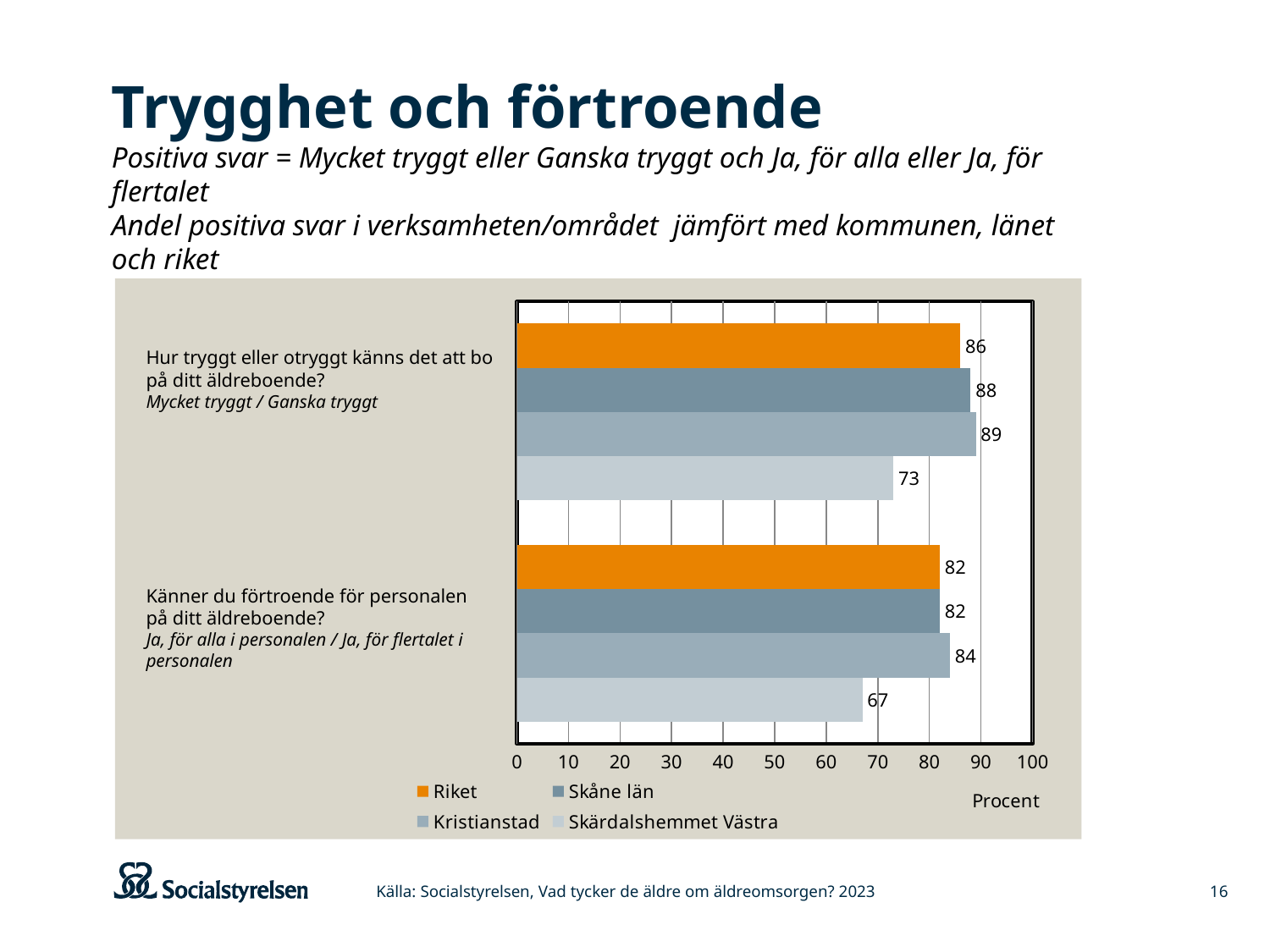
What is the value for Kristianstad on the question 'Känner du förtroende för personalen på ditt äldreboende?'? 84 What is the value for Skärdalshemmet Västra on the question 'Känner du förtroende för personalen på ditt äldreboende?'? 67 Which series has the lowest value on the question 'Känner du förtroende för personalen på ditt äldreboende?'? Skärdalshemmet Västra What unit label is shown under the x axis of the chart? Procent How many series does the legend list? 4 Which series has the highest value on the question 'Hur tryggt eller otryggt känns det att bo på ditt äldreboende?'? Kristianstad What is the value for Riket on the question 'Hur tryggt eller otryggt känns det att bo på ditt äldreboende?'? 86 What is the value for Skärdalshemmet Västra on the question 'Hur tryggt eller otryggt känns det att bo på ditt äldreboende?'? 73 What is the difference between Kristianstad and Skärdalshemmet Västra on the question 'Hur tryggt eller otryggt känns det att bo på ditt äldreboende?'? 16 What kind of chart is shown on the slide? Bar chart How many question categories are shown on the y axis of the chart? 2 Which is larger on the question 'Känner du förtroende för personalen på ditt äldreboende?': Kristianstad or Skärdalshemmet Västra? Kristianstad